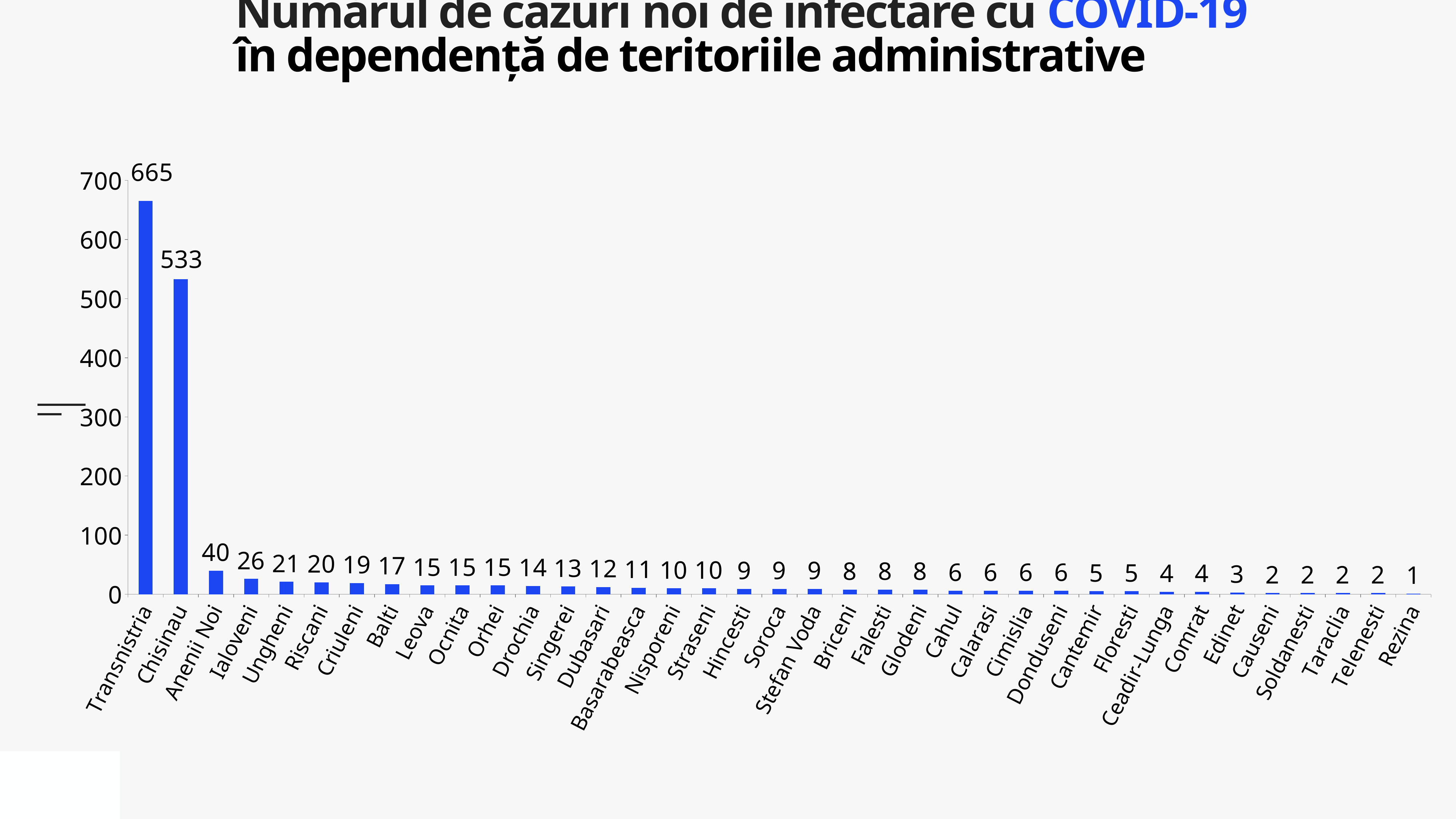
Which category has the lowest value? Rezina What is the value for Balti? 17 Do the values rise or fall from left to right along the x axis? fall What is the value for Chisinau? 533 Which category has the highest value? Transnistria What is the difference between the values for Transnistria and Chisinau? 132 How many categories are shown on the x axis? 37 Which is larger, the value for Ialoveni or the value for Ungheni? Ialoveni What is the value for Transnistria? 665 What kind of chart is shown on the slide? bar chart Is the value for Chisinau greater or less than 500? greater What is the value for Anenii Noi? 40